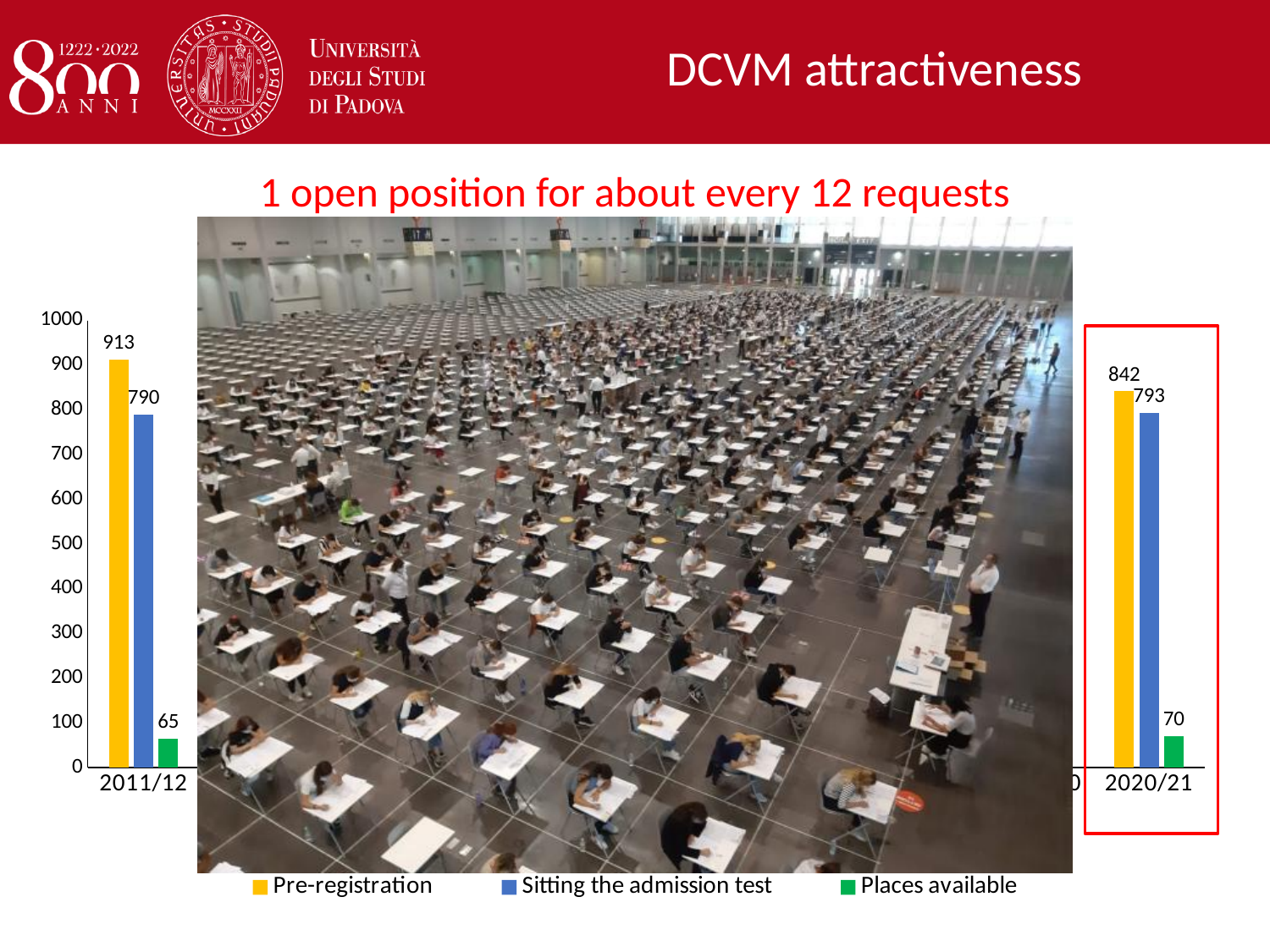
Which series has the lowest value in 2011/12? Places available What is the Pre-registration value for 2020/21? 842 How many Places available are shown for 2011/12? 65 What is the difference between Pre-registration and Places available in 2020/21? 772 What is the Pre-registration value for 2011/12? 913 Is the Pre-registration value for 2011/12 greater or less than 900? greater Which is larger: Sitting the admission test in 2011/12 or Sitting the admission test in 2020/21? 2020/21 What is the difference between Pre-registration in 2011/12 and Pre-registration in 2020/21? 71 What is the value for Sitting the admission test in 2020/21? 793 What is the Places available value for 2020/21? 70 What kind of chart is shown on the slide? bar chart How many series does the legend list? 3